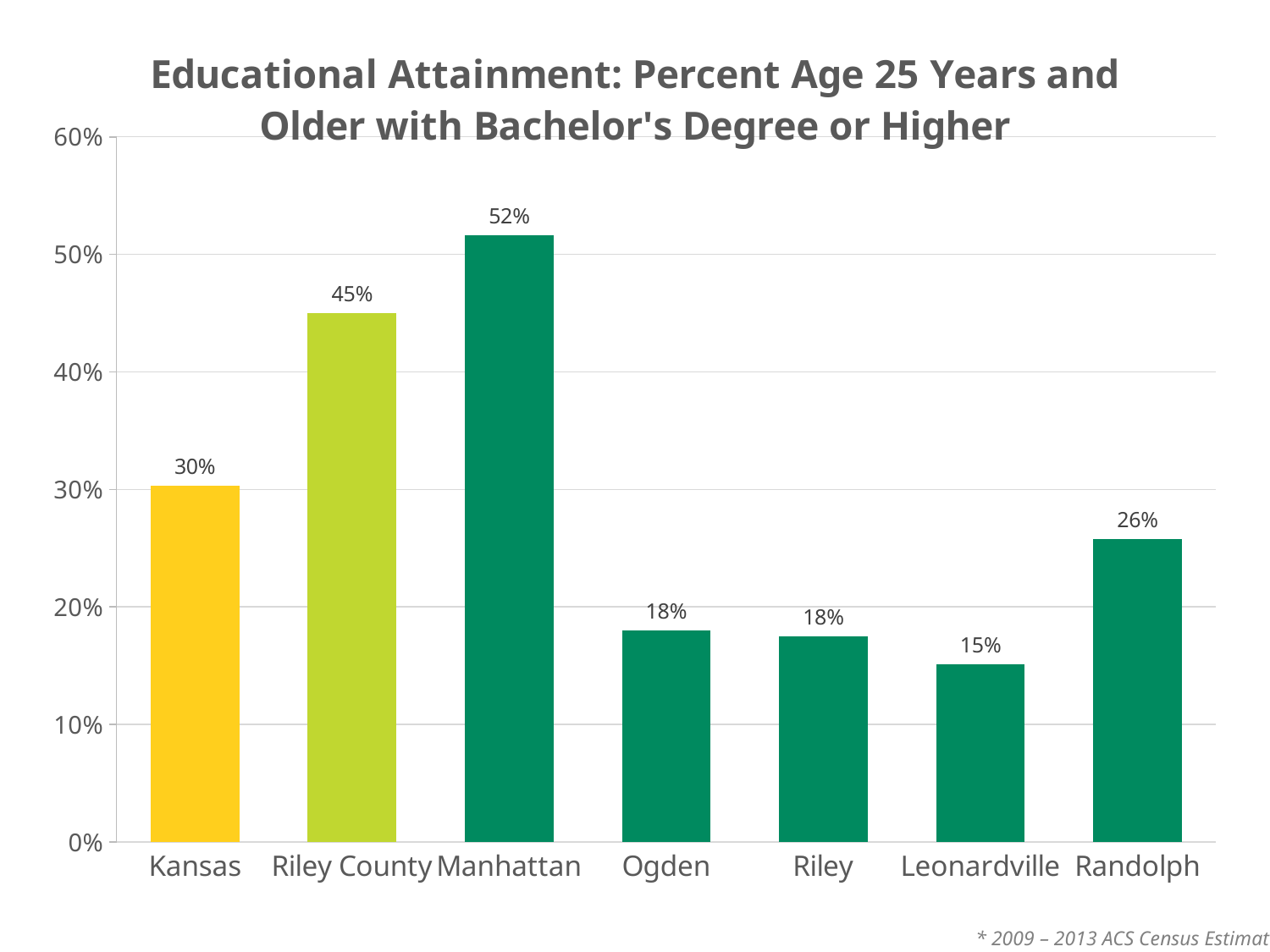
How many categories are shown on the x axis? 7 What is the difference between the values for Manhattan and Riley County? 7% What is the value for Randolph? 26% Which category has the highest value? Manhattan What is the value for Manhattan? 52% What is the value for Kansas? 30% What kind of chart is shown on the slide? Bar chart Is the value for Riley County greater or less than 40%? greater What is the value for Leonardville? 15% Which category has the lowest value? Leonardville Which is larger, the value for Randolph or the value for Ogden? Randolph What is the difference between the values for Kansas and Leonardville? 15%